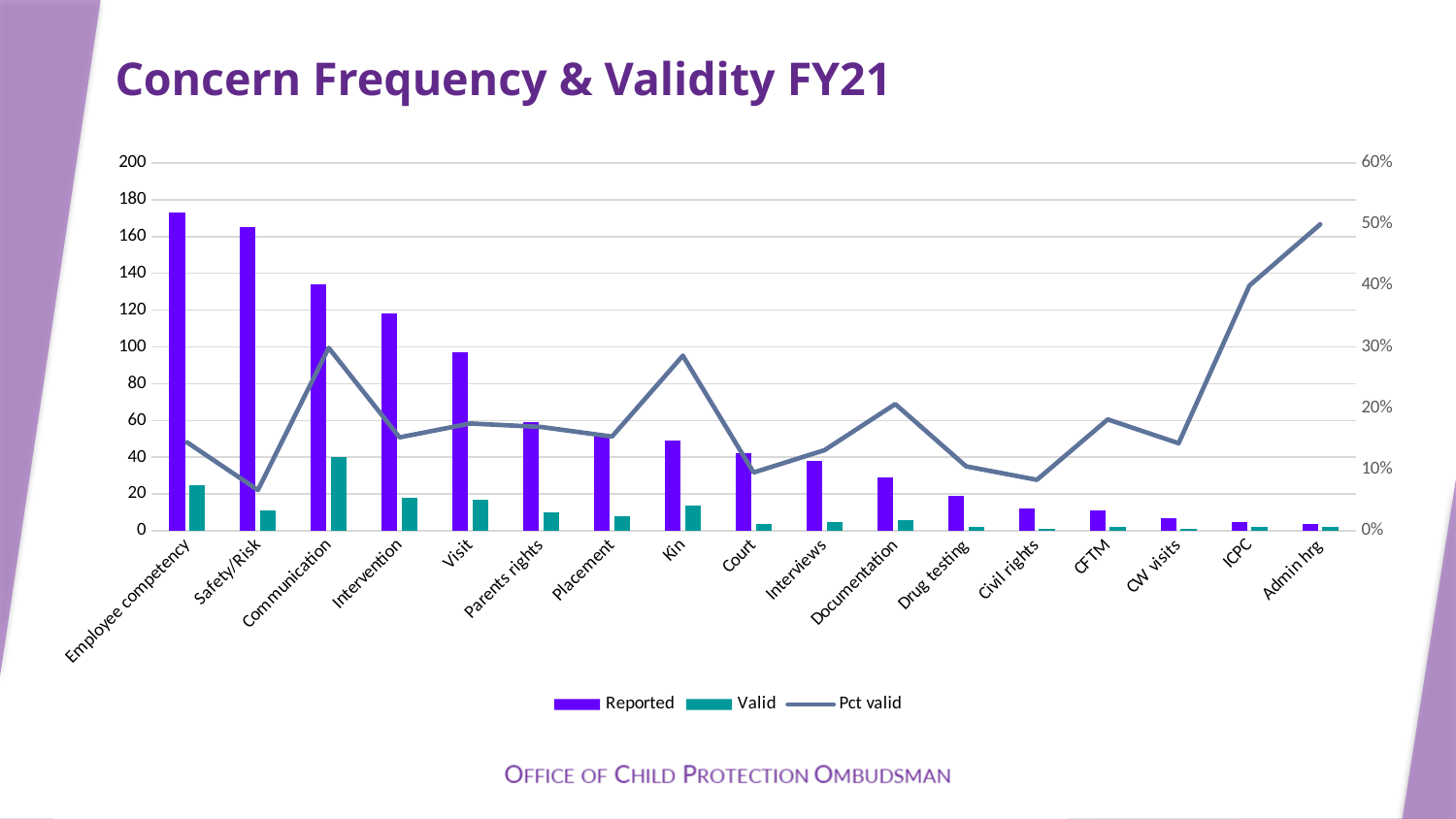
Is the Pct valid value for Admin hrg greater or less than 40%? greater Which category has the highest Pct valid value? Admin hrg What kind of chart is shown on the slide? bar chart with a line Which category has the highest Reported value? Employee competency Which has the larger Reported value, Visit or Kin? Visit How many categories are shown on the x axis? 17 Which category has the highest Valid value? Communication What is the title of the chart? Concern Frequency & Validity FY21 Do the Reported values generally rise or fall from left to right along the x axis? fall Is the Reported value for Employee competency greater or less than 160? greater Is the Reported value for Kin greater or less than 60? less How many series does the legend list? 3